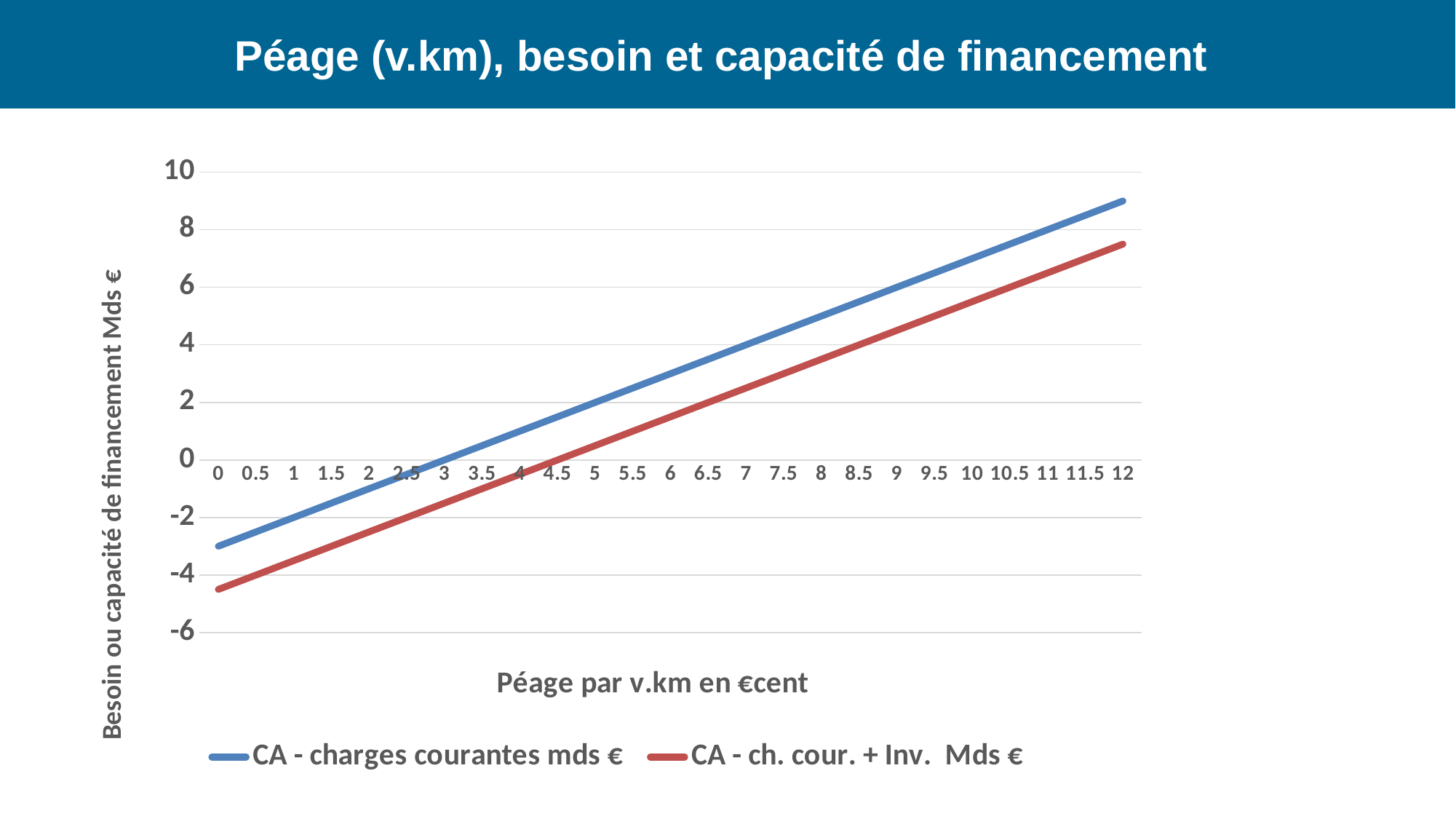
At a péage of 6 €cent, which series has the larger value: 'CA - charges courantes mds €' or 'CA - ch. cour. + Inv. Mds €'? CA - charges courantes mds € Is the value for 'CA - ch. cour. + Inv. Mds €' at a péage of 0 €cent greater or less than -4? less Is the value for 'CA - ch. cour. + Inv. Mds €' at a péage of 12 €cent greater or less than 8? less Do the values of the 'CA - charges courantes mds €' series rise or fall as the péage per v.km increases? rise What kind of chart is shown on the slide? line chart Do the values of the 'CA - ch. cour. + Inv. Mds €' series rise or fall along the x axis? rise How many points are marked along the x axis (from 0 to 12)? 25 Which colour is used for the 'CA - ch. cour. + Inv. Mds €' series? red How many series does the legend list? 2 What is the label of the x axis? Péage par v.km en €cent Is the value for 'CA - charges courantes mds €' at a péage of 0 €cent greater or less than -4? greater